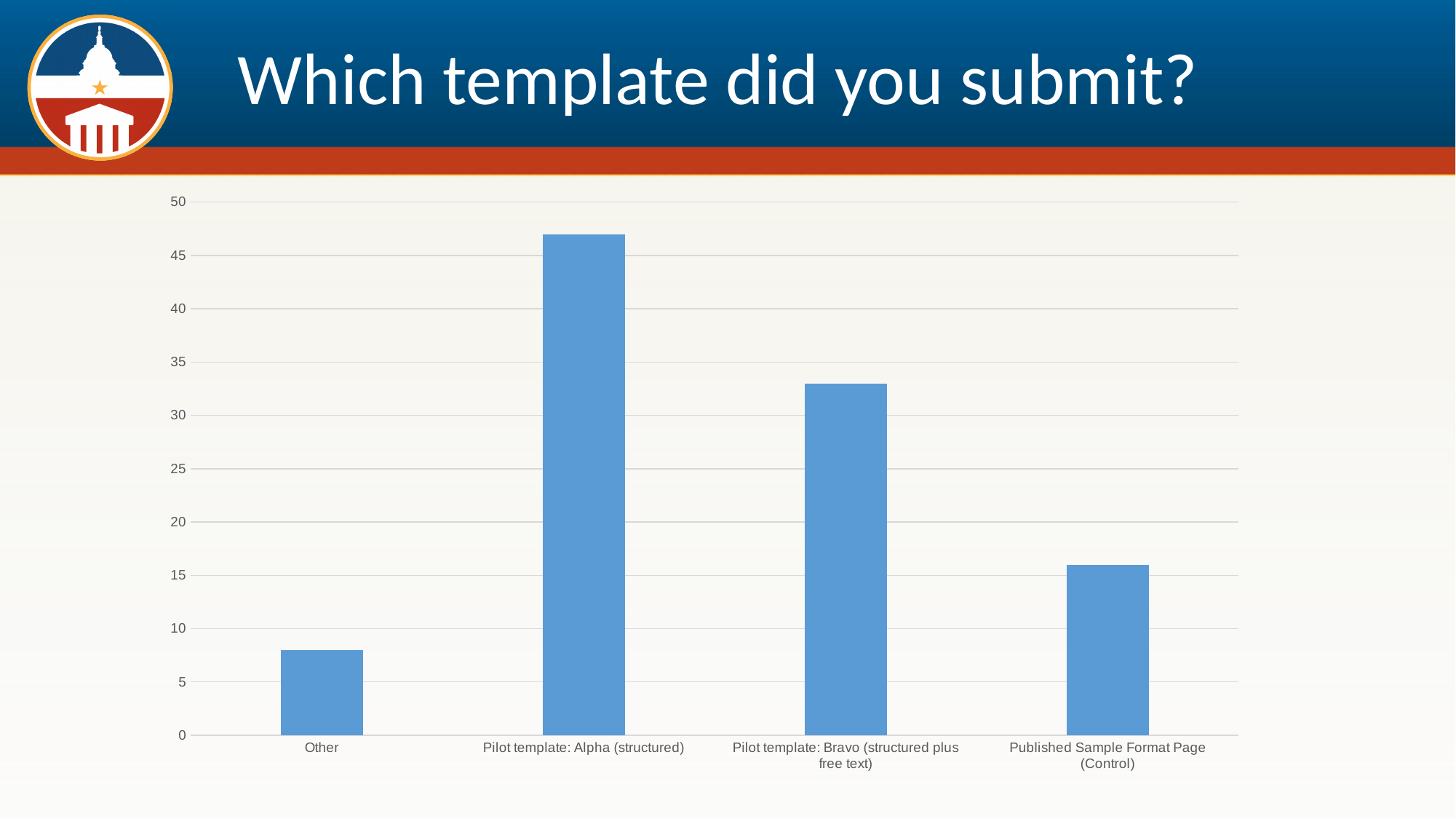
Is the value for Published Sample Format Page (Control) greater or less than 20? less What kind of chart is shown on the slide? bar chart Is the value for Pilot template: Bravo (structured plus free text) greater or less than 35? less Which category has the highest value? Pilot template: Alpha (structured) How many categories are shown on the x axis? 4 What is the maximum value shown on the y axis? 50 Is the value for Pilot template: Alpha (structured) greater or less than 45? greater Which is larger, the value for Pilot template: Bravo (structured plus free text) or the value for Published Sample Format Page (Control)? Pilot template: Bravo (structured plus free text) Which category has the lowest value? Other What is the title of the slide? Which template did you submit?